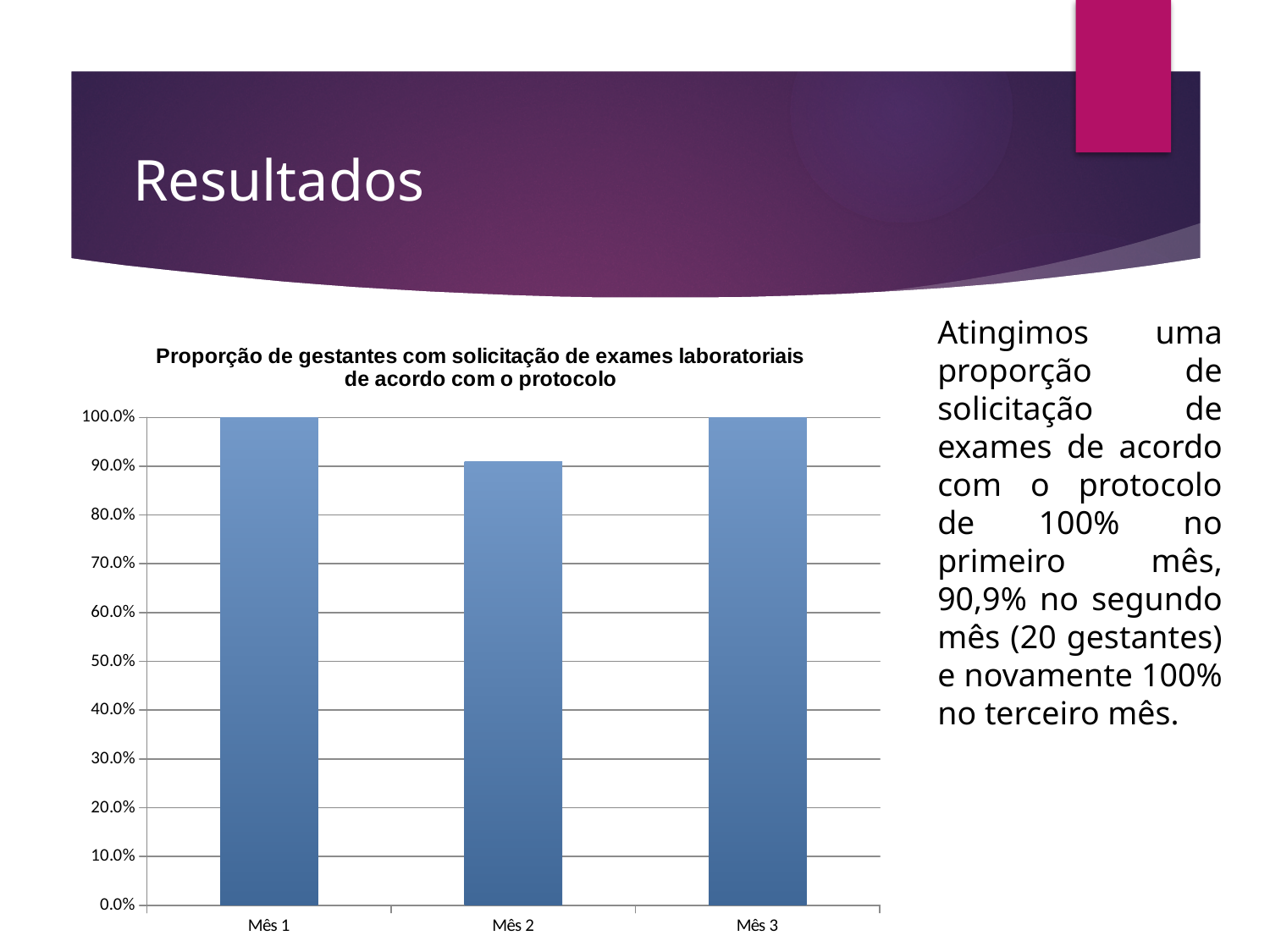
What is the difference between the values for Mês 1 and Mês 3? 0.0% What type of chart is shown on the slide? bar chart Which month has the lowest value? Mês 2 Which is larger, the value for Mês 1 or the value for Mês 2? Mês 1 What is the title of the chart? Proporção de gestantes com solicitação de exames laboratoriais de acordo com o protocolo Does the value rise or fall from Mês 1 to Mês 2? fall Which is larger, the value for Mês 2 or the value for Mês 3? Mês 3 Is the value for Mês 2 greater or less than 80.0%? greater What is the value for Mês 1? 100.0% How many categories are shown on the x axis of the chart? 3 Is the value for Mês 2 greater or less than 100.0%? less What is the value for Mês 3? 100.0%